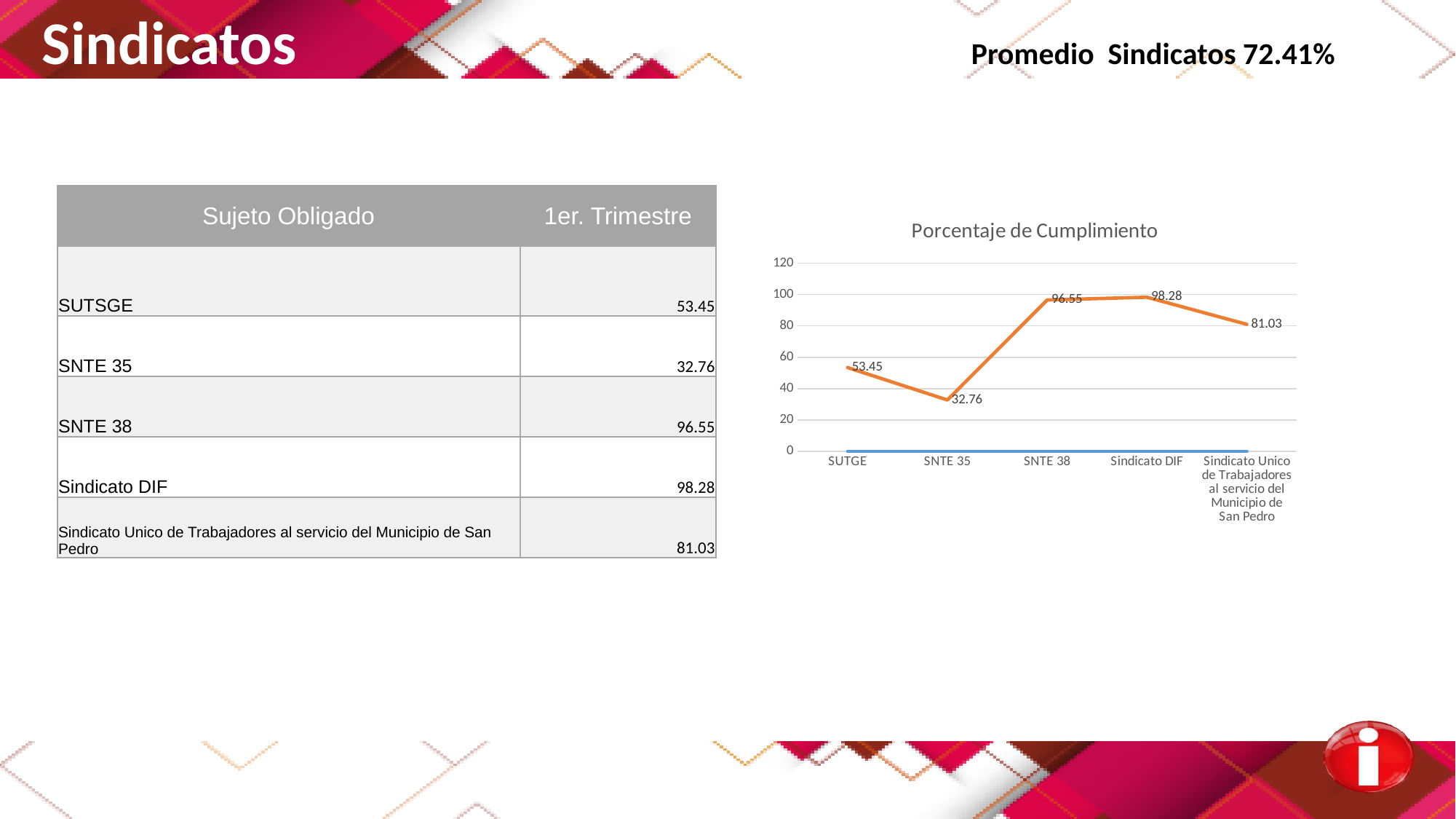
What is the title of the chart on the slide? Porcentaje de Cumplimiento What is the value for SUTGE in the Porcentaje de Cumplimiento chart? 53.45 What kind of chart is the Porcentaje de Cumplimiento chart? line chart Which is larger in the Porcentaje de Cumplimiento chart, the value for SUTGE or the value for SNTE 35? SUTGE What is the difference between the values for SNTE 38 and SNTE 35 in the Porcentaje de Cumplimiento chart? 63.79 Is the value for SNTE 35 in the Porcentaje de Cumplimiento chart greater or less than 40? less Which category has the lowest value in the Porcentaje de Cumplimiento chart? SNTE 35 What is the value for Sindicato DIF in the Porcentaje de Cumplimiento chart? 98.28 How many categories are shown on the x axis of the Porcentaje de Cumplimiento chart? 5 What is the value for Sindicato Unico de Trabajadores al servicio del Municipio de San Pedro in the Porcentaje de Cumplimiento chart? 81.03 What is the value for SNTE 38 in the Porcentaje de Cumplimiento chart? 96.55 Which category has the highest value in the Porcentaje de Cumplimiento chart? Sindicato DIF